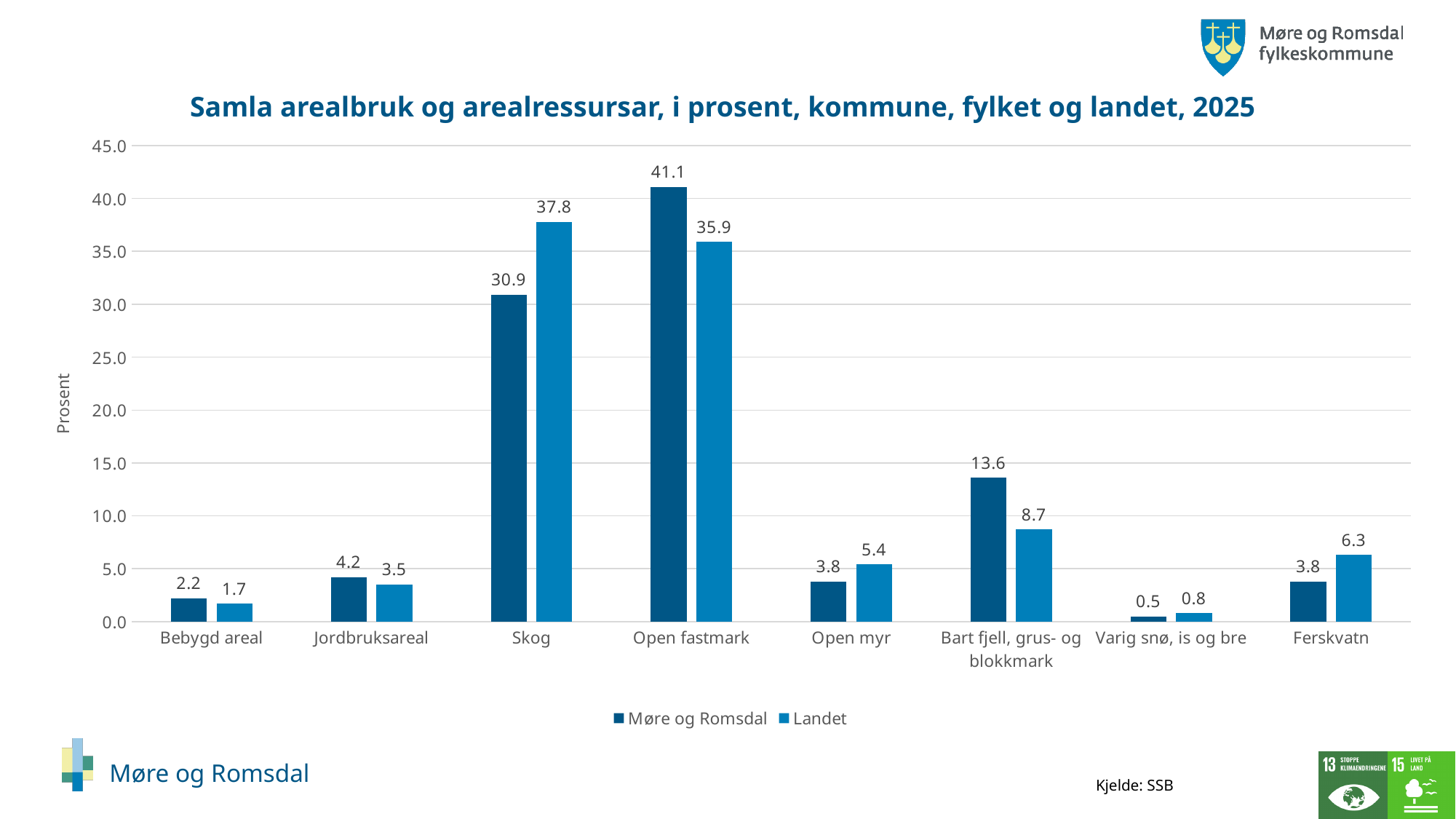
Which category has the lowest value in the Landet series? Varig snø, is og bre How many series does the legend list? 2 What kind of chart is shown on the slide? bar chart What is the difference between the Møre og Romsdal and Landet values for Skog? 6.9 Is the Landet value for Open fastmark greater or less than 35.0? greater What is the value for Bart fjell, grus- og blokkmark in the Møre og Romsdal series? 13.6 What is the value for Open myr in the Landet series? 5.4 Which category has the highest value in the Møre og Romsdal series? Open fastmark For Ferskvatn, which series has the larger value, Møre og Romsdal or Landet? Landet What is the label of the y axis? Prosent How many categories are shown on the x axis? 8 What is the value for Skog in the Møre og Romsdal series? 30.9